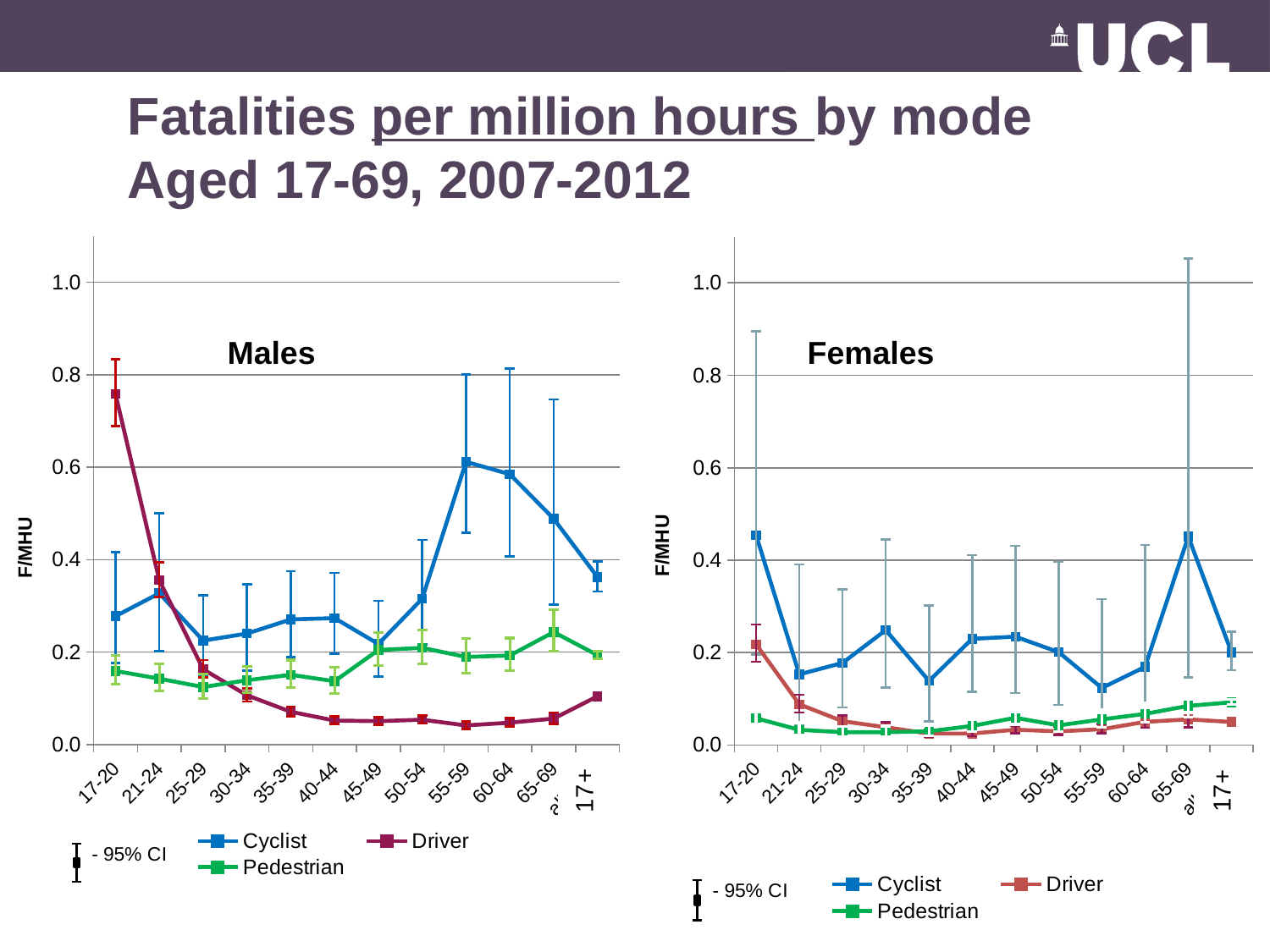
In the Males chart, is the Driver value for 40-44 greater or less than 0.2? less In the Females chart, is the Cyclist value for 17-20 greater or less than 0.4? greater In the Males chart, does the Driver series rise or fall from 17-20 to 40-44? fall What kind of chart is the Males chart? line chart In the Females chart, which is larger at 17-20, the Cyclist value or the Driver value? Cyclist In the Males chart, is the Driver value for 17-20 greater or less than 0.6? greater In the Males chart, which age group has the highest Driver value? 17-20 What is the label on the vertical axis of the Females chart? F/MHU In the Males chart, which is larger at 17-20, the Driver value or the Cyclist value? Driver How many series does the legend of the Females chart list? 3